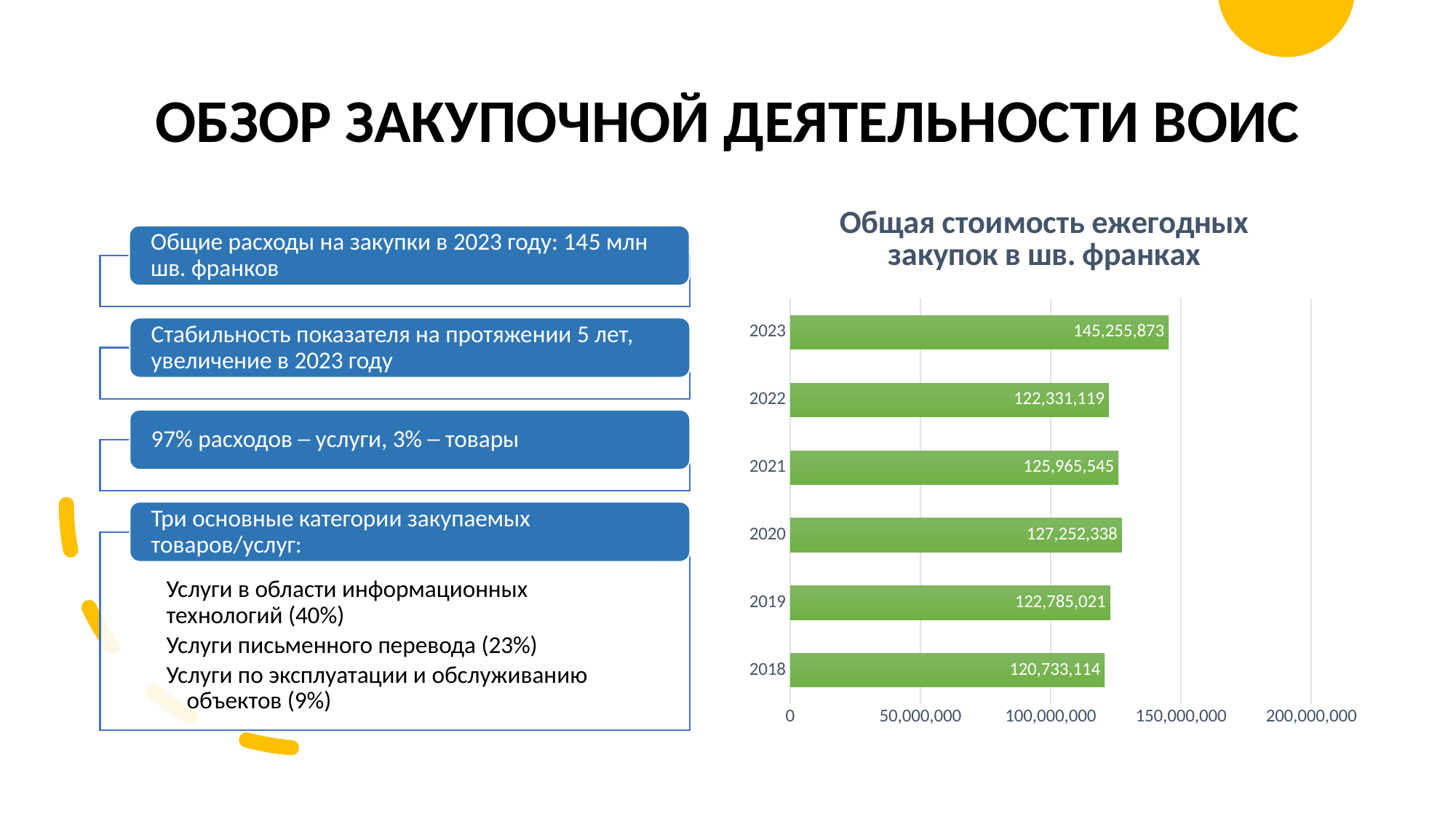
Which year has the lowest value in the chart? 2018 What is the value for 2023 in the chart? 145,255,873 What is the difference between the values for 2023 and 2022? 22,924,754 What is the title of the chart? Общая стоимость ежегодных закупок в шв. франках What kind of chart is shown on the slide? bar chart How many years are shown in the chart? 6 Which is larger, the value for 2021 or the value for 2022? 2021 What is the value for 2020 in the chart? 127,252,338 What is the difference between the values for 2020 and 2021? 1,286,793 Is the value for 2023 greater or less than 100,000,000? greater What is the value for 2018 in the chart? 120,733,114 Which year has the highest value in the chart? 2023